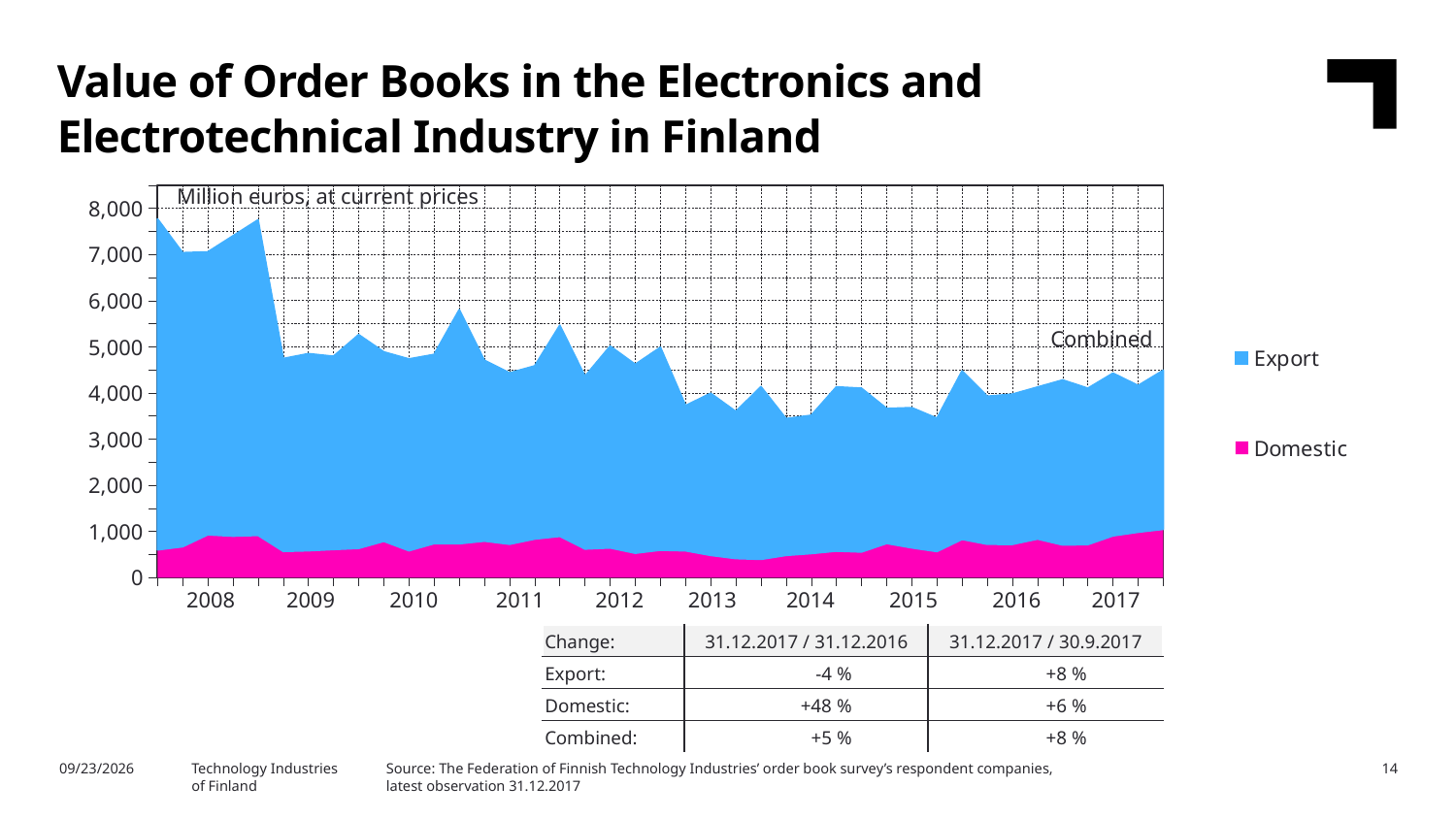
What kind of chart is shown on the slide? Area chart What unit is stated at the top of the chart? Million euros, at current prices Is the combined value at the end of 2017 greater or less than 5,000? less How many series does the chart legend list? 2 According to the table below the chart, what is the Domestic change for 31.12.2017 / 31.12.2016? +48 % Does the combined value of order books rise or fall overall from 2008 to 2017? fall Which series is larger throughout the chart, Export or Domestic? Export Is the combined value at the start of 2008 greater or less than 7,000? greater How many years are labelled on the x axis of the chart? 10 Is the Domestic value in 2014 greater or less than 1,000? less In which year does the combined value of order books reach its highest level? 2008 What are the two series named in the chart legend? Export and Domestic